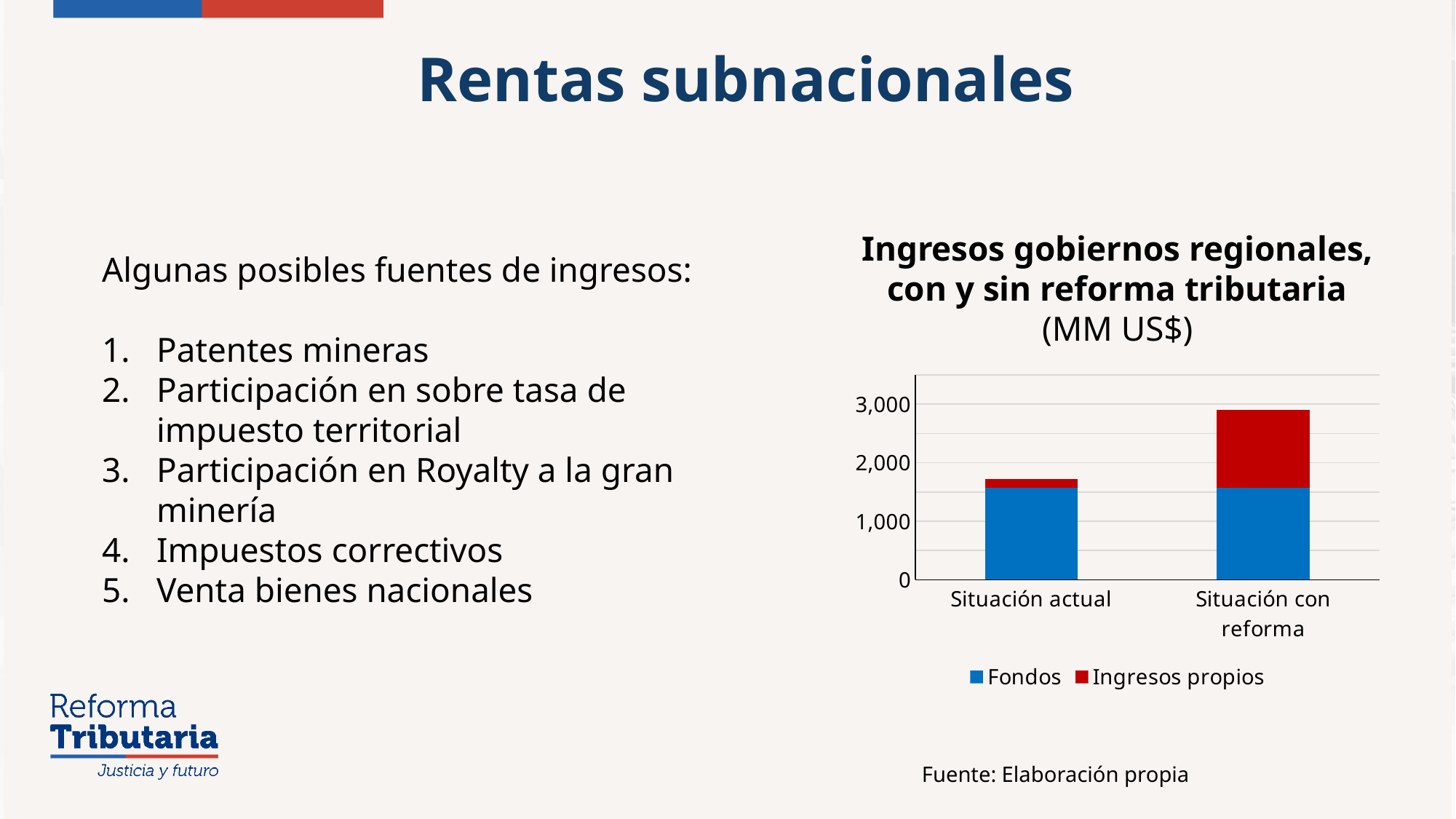
Do the total bar values rise or fall from Situación actual to Situación con reforma? rise Which category has the higher total bar, Situación actual or Situación con reforma? Situación con reforma Is the total for Situación con reforma greater or less than 2,000? greater How many series does the chart's legend list? 2 Is the Fondos value for Situación actual greater or less than 1,000? greater What is the title of the chart? Ingresos gobiernos regionales, con y sin reforma tributaria (MM US$) In which category is the Ingresos propios segment larger, Situación actual or Situación con reforma? Situación con reforma How many categories are shown on the x axis of the chart? 2 Which series are listed in the chart's legend? Fondos and Ingresos propios What kind of chart is shown on the slide? Stacked bar chart Is the total for Situación actual greater or less than 2,000? less Which category has the lower total bar? Situación actual